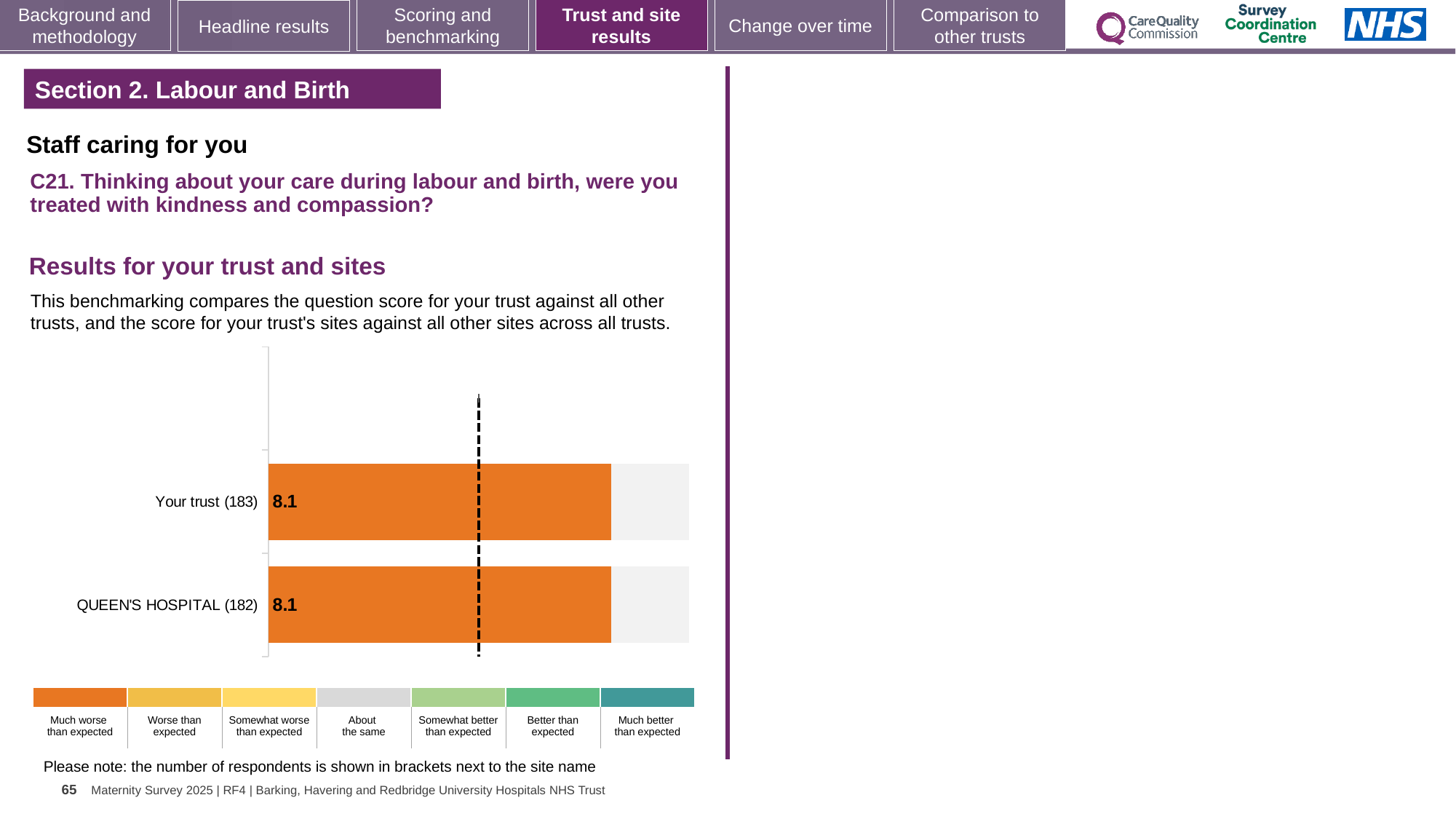
How many bars are plotted in the chart? 2 What is the difference between the score for Your trust and the score for QUEEN'S HOSPITAL? 0.0 What kind of chart is shown on the slide? Bar chart What is the score for Your trust? 8.1 How many categories does the colour legend below the chart list? 7 How many respondents are shown in brackets for QUEEN'S HOSPITAL? 182 Which legend category does the colour of the bars correspond to? Much worse than expected How many respondents are shown in brackets for Your trust? 183 What is the score for QUEEN'S HOSPITAL? 8.1 Which survey question does the chart relate to? C21. Thinking about your care during labour and birth, were you treated with kindness and compassion?